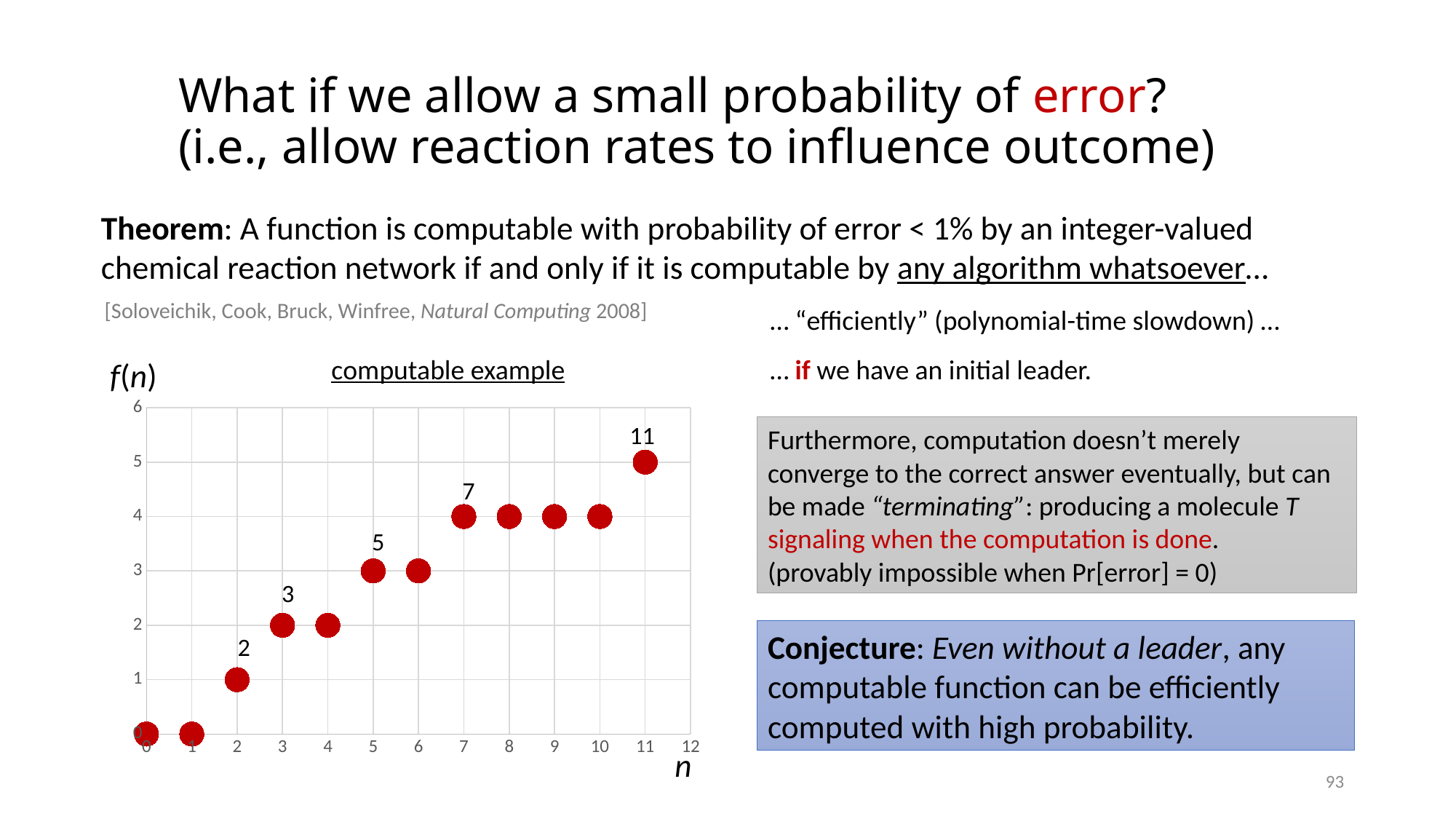
What is the value of f(n) at n = 11? 5 At which value of n does f(n) reach its highest value? 11 What kind of chart is shown on the slide? scatter plot What is the lowest value of f(n) plotted in the chart? 0 What is the value of f(n) at n = 2? 1 What is the title of the chart? computable example Do the values of f(n) generally rise or fall as n increases? rise How many data points are plotted in the chart? 12 What is the value of f(n) at n = 7? 4 What is the difference between f(n) at n = 11 and f(n) at n = 3? 3 What is the value of f(n) at n = 5? 3 Which is larger, f(n) at n = 6 or f(n) at n = 9? n = 9